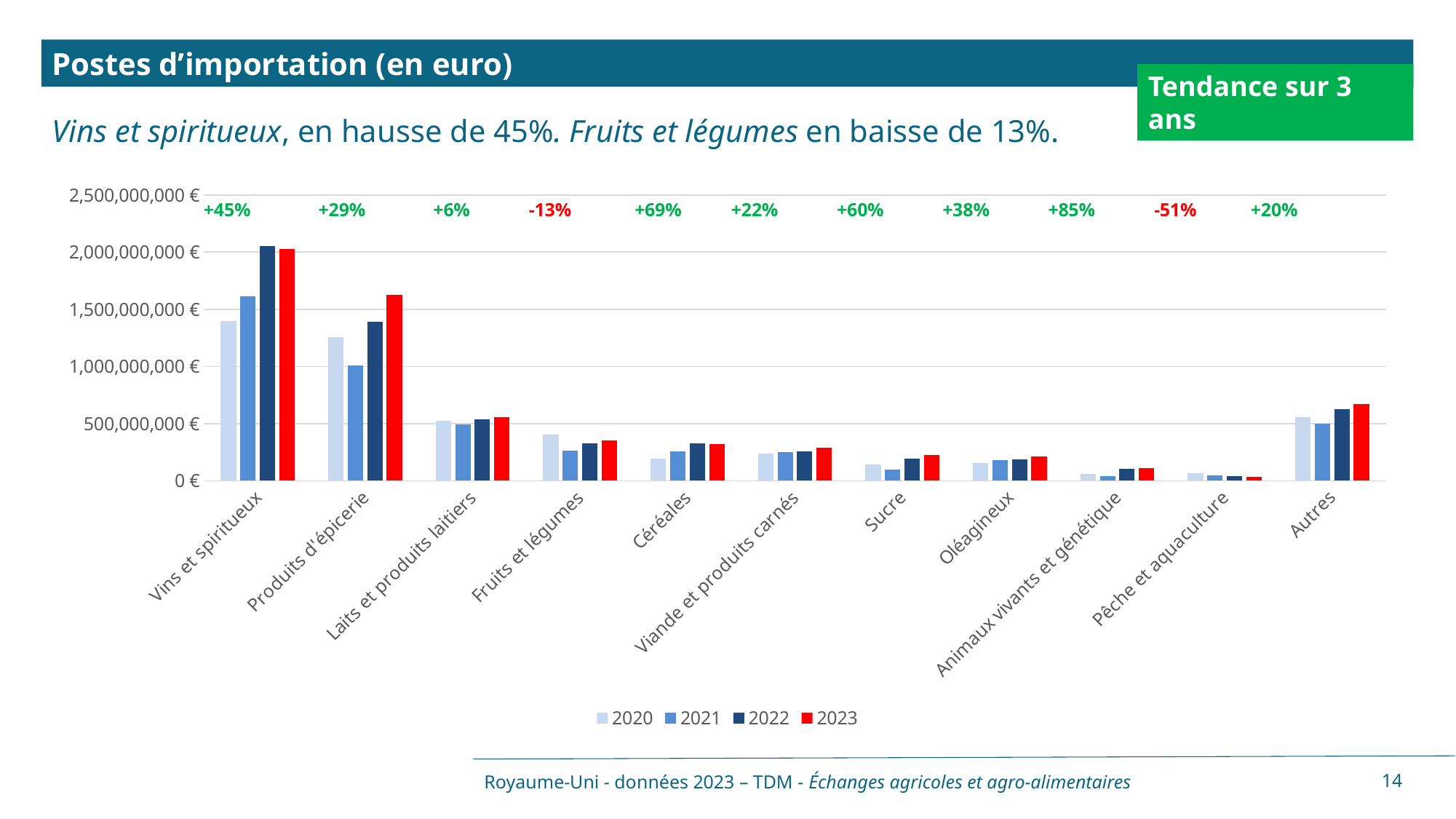
How many categories show a negative (red) 3-year trend percentage? 2 Is the 2023 value for Vins et spiritueux greater or less than 1,500,000,000 €? greater What 3-year trend percentage is printed above Animaux vivants et génétique? +85% What 3-year trend percentage is printed above Céréales? +69% What kind of chart is shown on the slide? bar chart Which category has the highest 2023 value? Vins et spiritueux Which category has the lowest 2023 value? Pêche et aquaculture Is the 2023 value for Fruits et légumes greater or less than 500,000,000 €? less What 3-year trend percentage is printed above Pêche et aquaculture? -51% Which is larger in 2023: Autres or Laits et produits laitiers? Autres How many series does the legend list? 4 How many import categories are shown on the x axis? 11